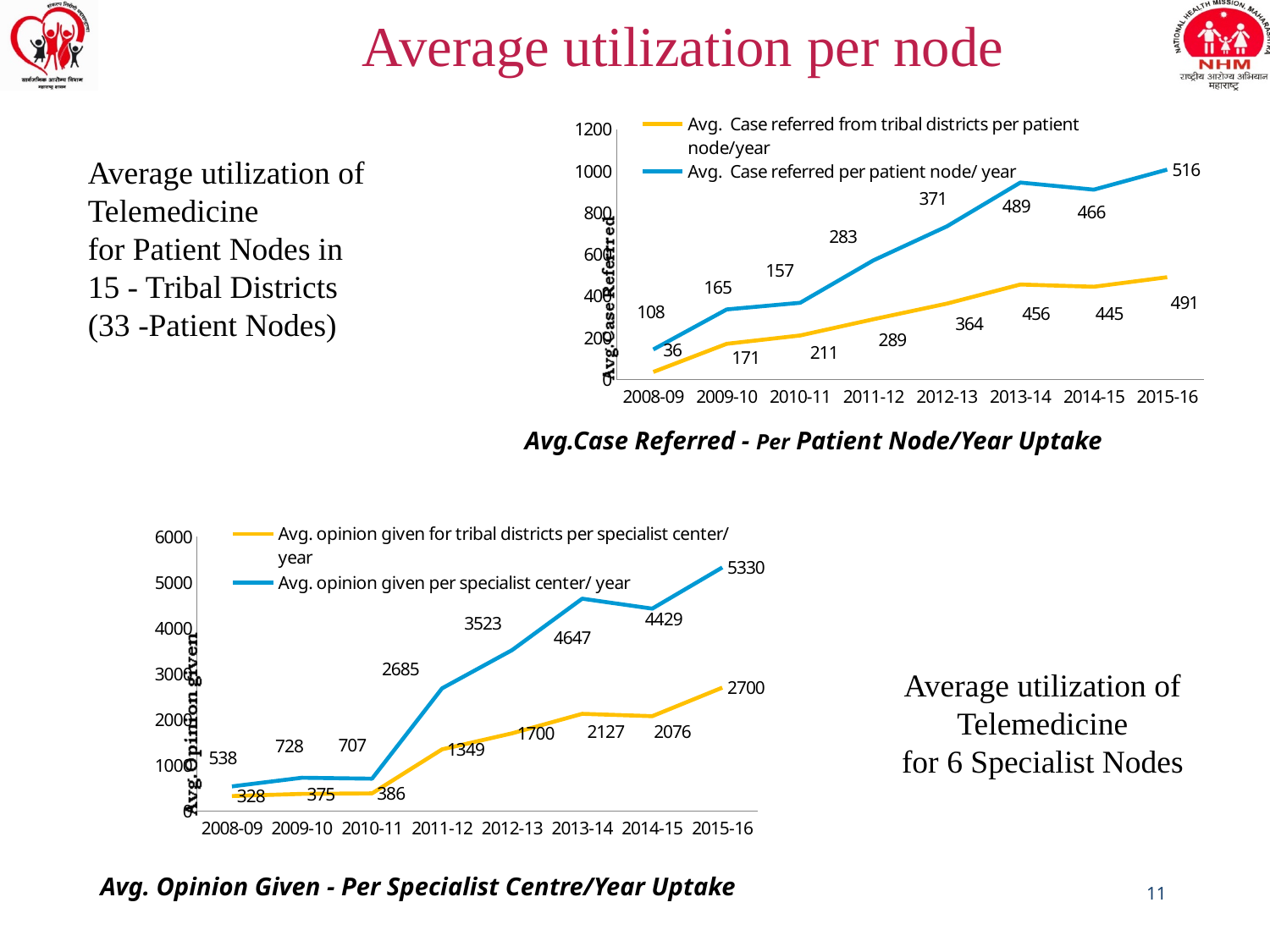
What kind of chart is the 'Avg. Opinion Given - Per Specialist Centre/Year Uptake' chart? Line chart In the 'Avg. Opinion Given - Per Specialist Centre/Year Uptake' chart, by how much did 'Avg. opinion given per specialist center/ year' fall from 2013-14 to 2014-15? 218 In the 'Avg. Opinion Given - Per Specialist Centre/Year Uptake' chart, what is the value of 'Avg. opinion given per specialist center/ year' for 2015-16? 5330 In the 'Avg.Case Referred - Per Patient Node/Year Uptake' chart, what is the difference between the two series' values in 2015-16? 25 In the 'Avg.Case Referred - Per Patient Node/Year Uptake' chart, in which year is 'Avg. Case referred per patient node/ year' highest? 2015-16 In the 'Avg. Opinion Given - Per Specialist Centre/Year Uptake' chart, what is the value of 'Avg. opinion given for tribal districts per specialist center/ year' for 2011-12? 1349 In the 'Avg. Opinion Given - Per Specialist Centre/Year Uptake' chart, which year has the higher value for 'Avg. opinion given per specialist center/ year': 2009-10 or 2010-11? 2009-10 In the 'Avg.Case Referred - Per Patient Node/Year Uptake' chart, what is the value of 'Avg. Case referred from tribal districts per patient node/year' for 2008-09? 36 How many years are shown on the x axis of the 'Avg.Case Referred - Per Patient Node/Year Uptake' chart? 8 In the 'Avg.Case Referred - Per Patient Node/Year Uptake' chart, what is the value of 'Avg. Case referred per patient node/ year' for 2015-16? 516 In the 'Avg. Opinion Given - Per Specialist Centre/Year Uptake' chart, in which year is 'Avg. opinion given for tribal districts per specialist center/ year' lowest? 2008-09 How many series does the legend of the 'Avg.Case Referred - Per Patient Node/Year Uptake' chart list? 2